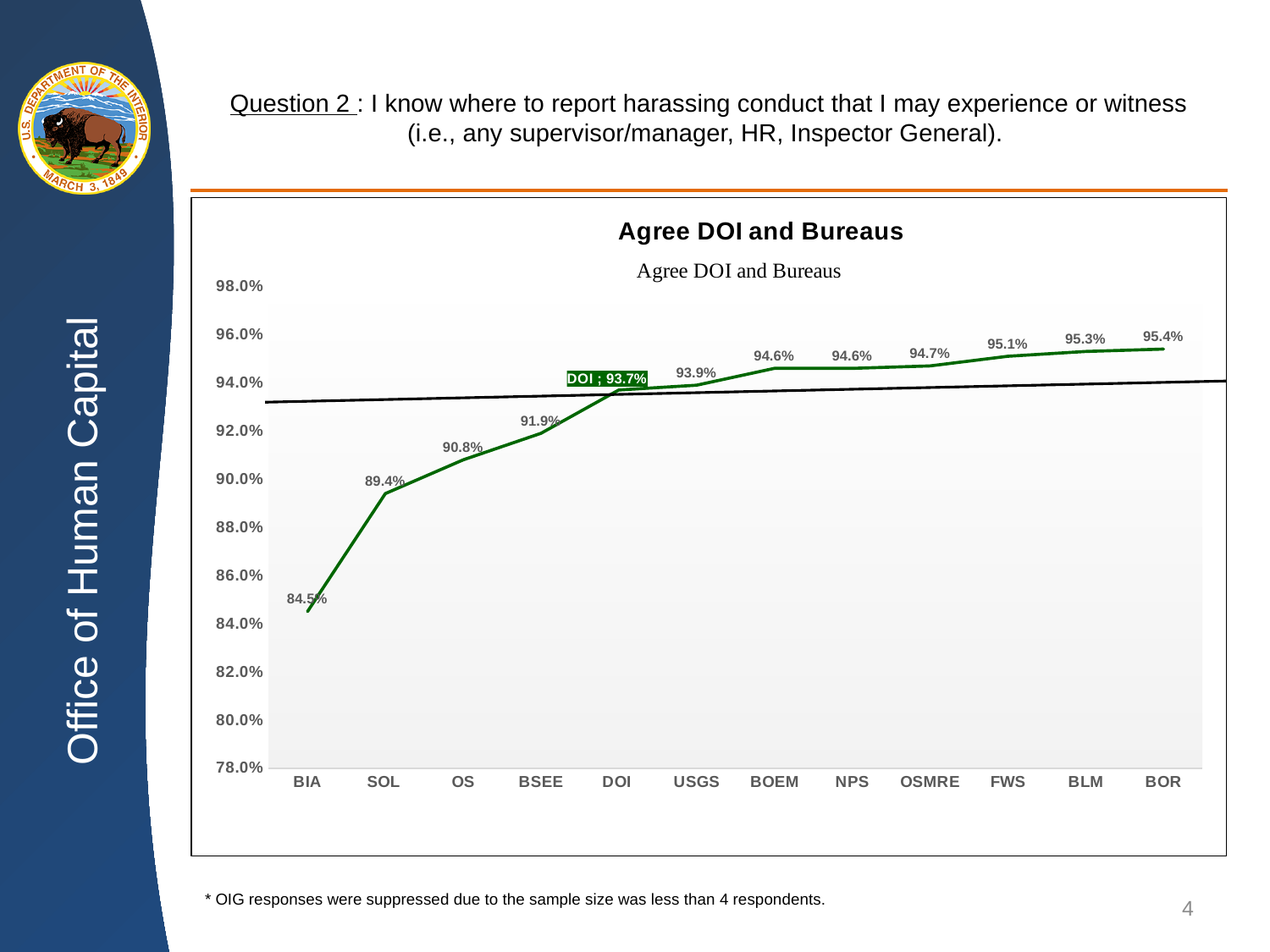
Which category has the lowest value? BIA What is the value for BIA? 84.5% What kind of chart is this? line chart Is the value for SOL greater or less than 90.0%? less What is the value for DOI? 93.7% Which category has the highest value? BOR What is the value for OSMRE? 94.7% How many categories are shown on the x axis? 12 What is the difference between the values for SOL and OS? 1.4% What is the difference between the values for BOR and BIA? 10.9% Which is larger, the value for BSEE or the value for USGS? USGS Do the values rise or fall from BIA to BOR along the x axis? rise